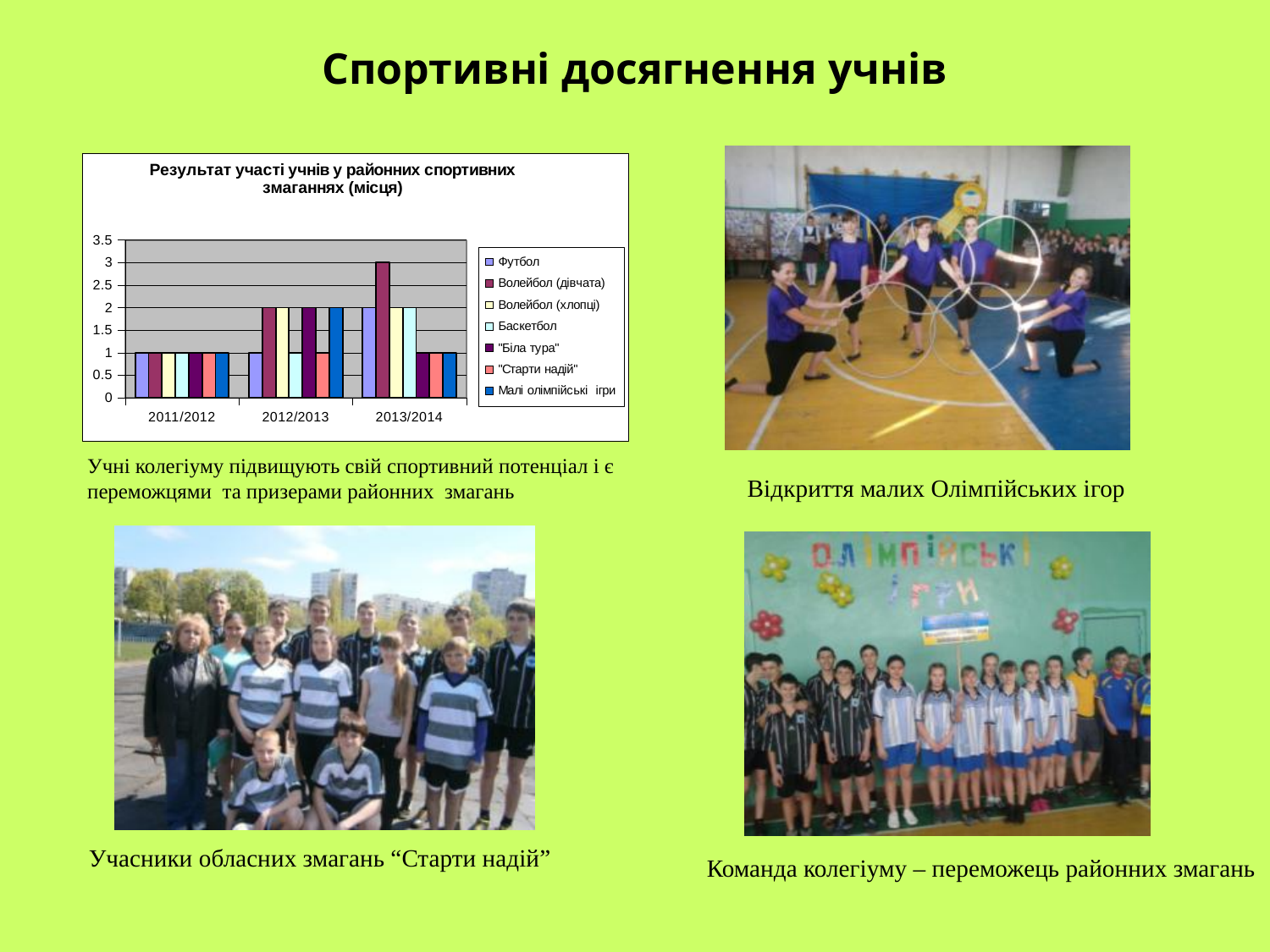
How many series does the chart legend list? 7 Is the value for Волейбол (дівчата) in 2013/2014 greater or less than 2.5? greater What is the difference between the value for Волейбол (дівчата) in 2013/2014 and its value in 2011/2012? 2 What is the value for Футбол in 2011/2012? 1 What is the value for Малі олімпійські ігри in 2012/2013? 2 What is the title of the chart on the slide? Результат участі учнів у районних спортивних змаганнях (місця) Which series has the highest value in 2013/2014? Волейбол (дівчата) Does the value for Волейбол (дівчата) rise or fall from 2011/2012 to 2013/2014? rise What is the value for Волейбол (дівчата) in 2013/2014? 3 Which is larger: the value for Волейбол (дівчата) in 2013/2014 or the value for Футбол in 2013/2014? Волейбол (дівчата) in 2013/2014 How many school-year categories are shown on the x axis of the chart? 3 What type of chart is shown on the slide? bar chart